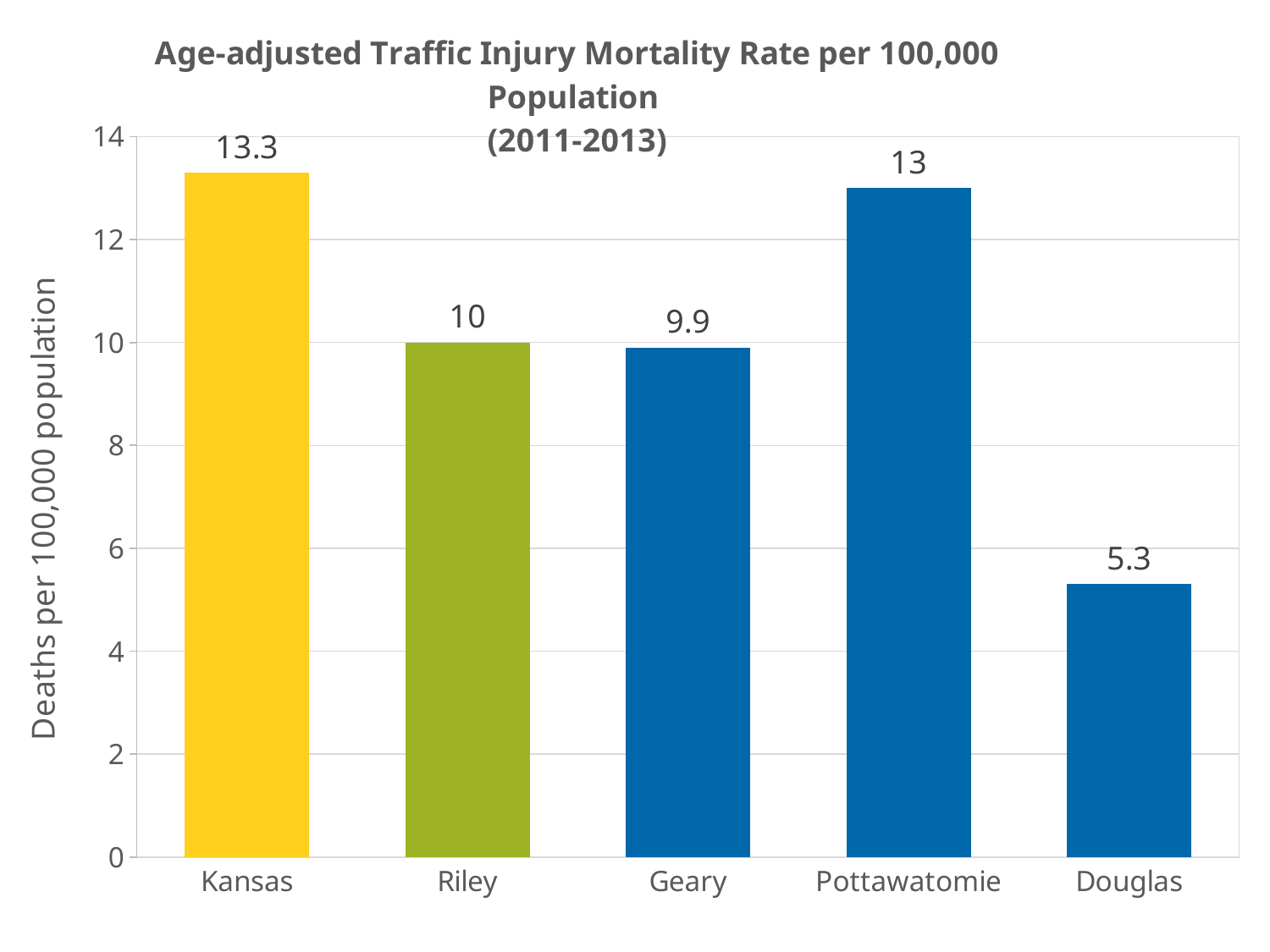
Which has a higher mortality rate, Pottawatomie or Geary? Pottawatomie What is the age-adjusted traffic injury mortality rate for Kansas? 13.3 Which category has the lowest traffic injury mortality rate? Douglas What is the value shown for Geary? 9.9 What kind of chart is shown on the slide? bar chart What is the difference between the values for Kansas and Douglas? 8 Is the value for Douglas greater or less than 6? less What is the age-adjusted traffic injury mortality rate for Douglas? 5.3 How many categories are shown on the x axis? 5 What is the label of the y axis? Deaths per 100,000 population Which category has the highest traffic injury mortality rate? Kansas What is the difference between the values for Pottawatomie and Riley? 3